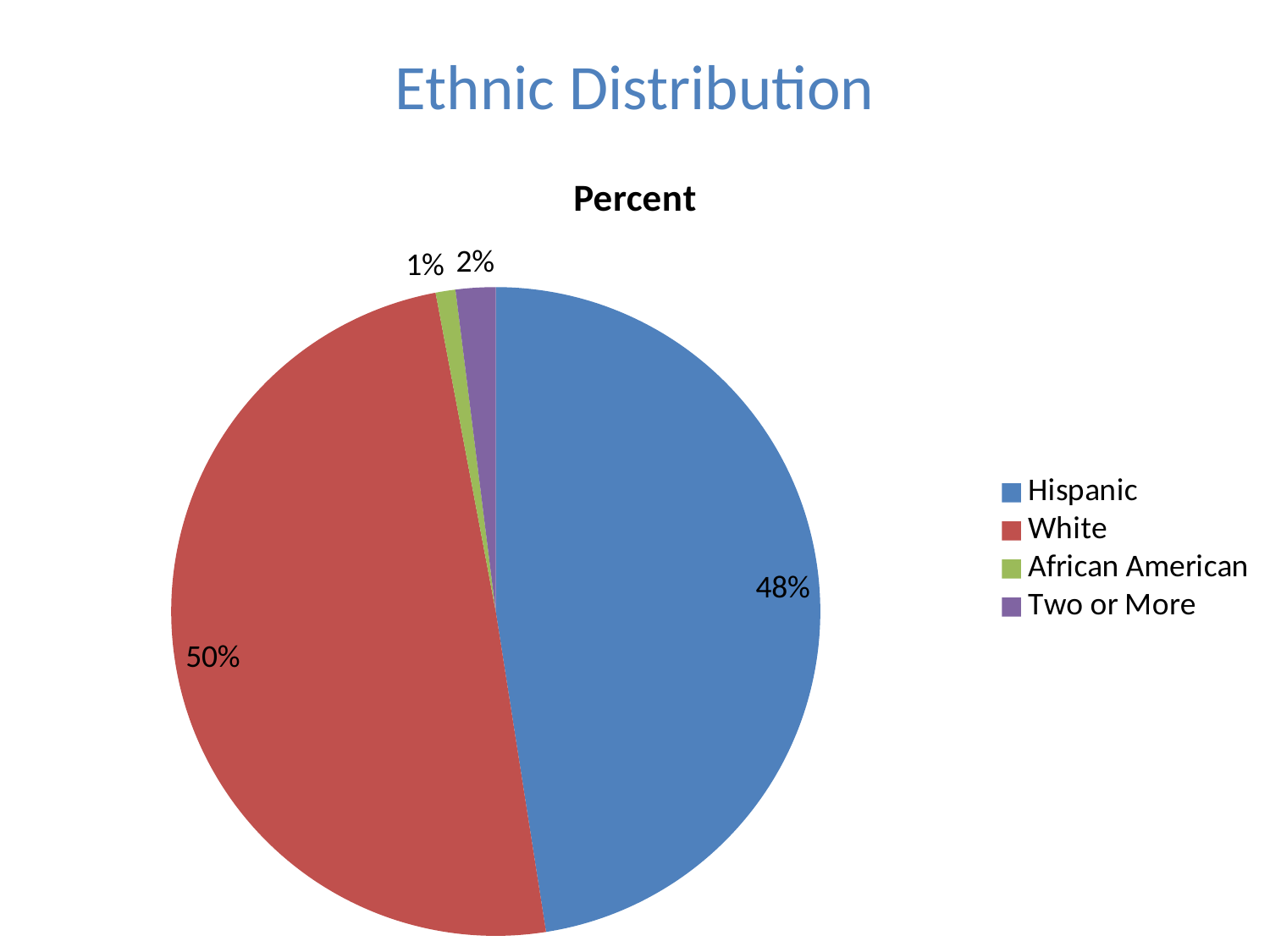
What percentage of the pie is African American? 1% What is the difference between the White and Hispanic shares? 2% What is the title of the chart? Percent What colour is the slice for White? Red Which category has the smallest share of the pie? African American What percentage of the pie is Hispanic? 48% Which is larger, the share for Two or More or the share for African American? Two or More What kind of chart is shown on the slide? Pie chart Which category has the largest share of the pie? White What percentage of the pie is Two or More? 2% What percentage of the pie is White? 50% How many categories does the legend list? 4